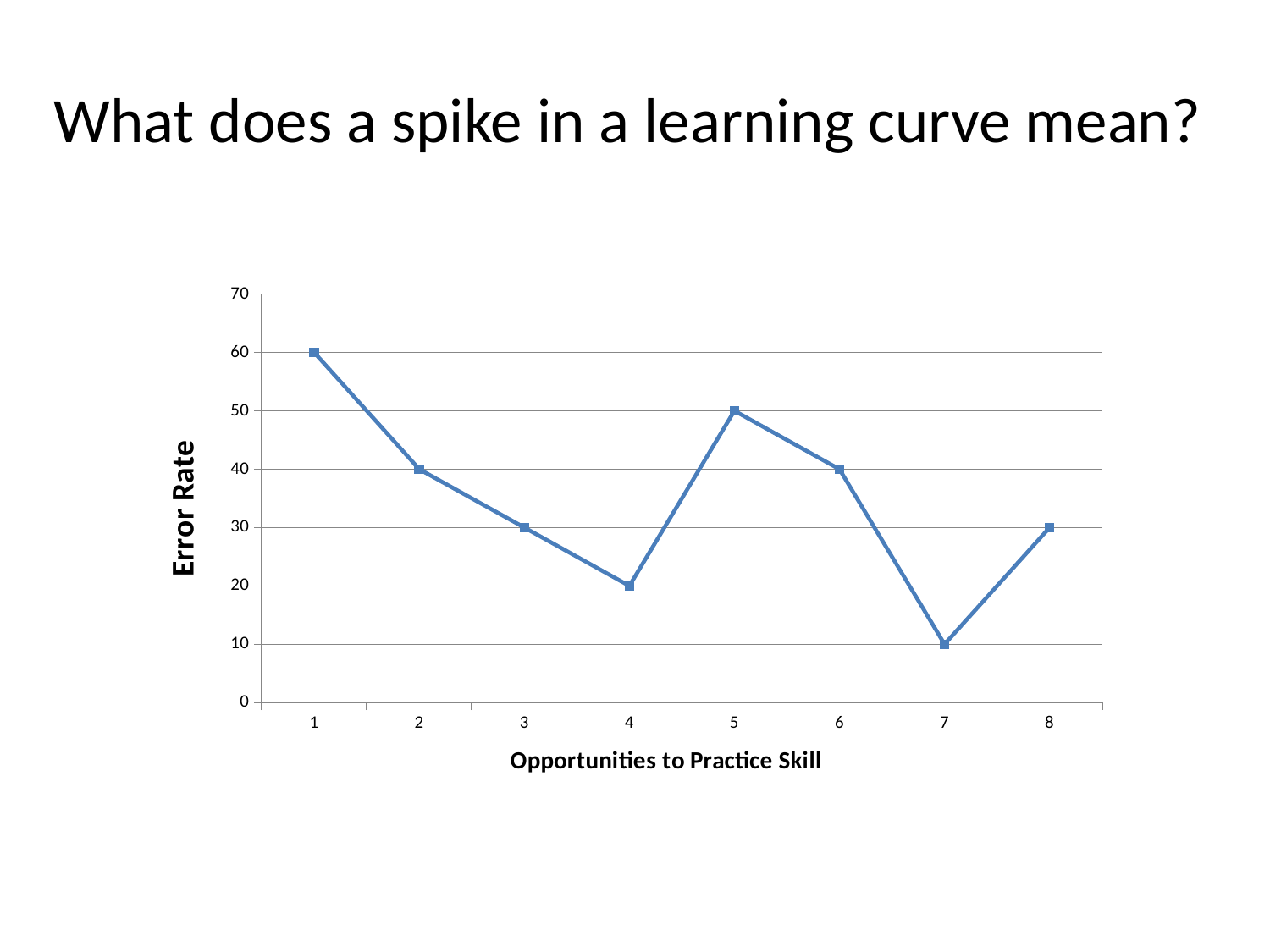
At which opportunity to practice skill is the error rate highest? 1 What is the difference in error rate between opportunity 4 and opportunity 5? 30 Which has a higher error rate, opportunity 3 or opportunity 6? opportunity 6 What is the label of the x axis? Opportunities to Practice Skill What is the error rate at opportunity 7? 10 What is the label of the y axis? Error Rate How many opportunities to practice skill are plotted on the x axis? 8 What is the error rate at opportunity 1? 60 Does the error rate rise or fall from opportunity 1 to opportunity 4? fall What kind of chart is shown on the slide? line chart At which opportunity to practice skill is the error rate lowest? 7 What is the error rate at opportunity 5? 50